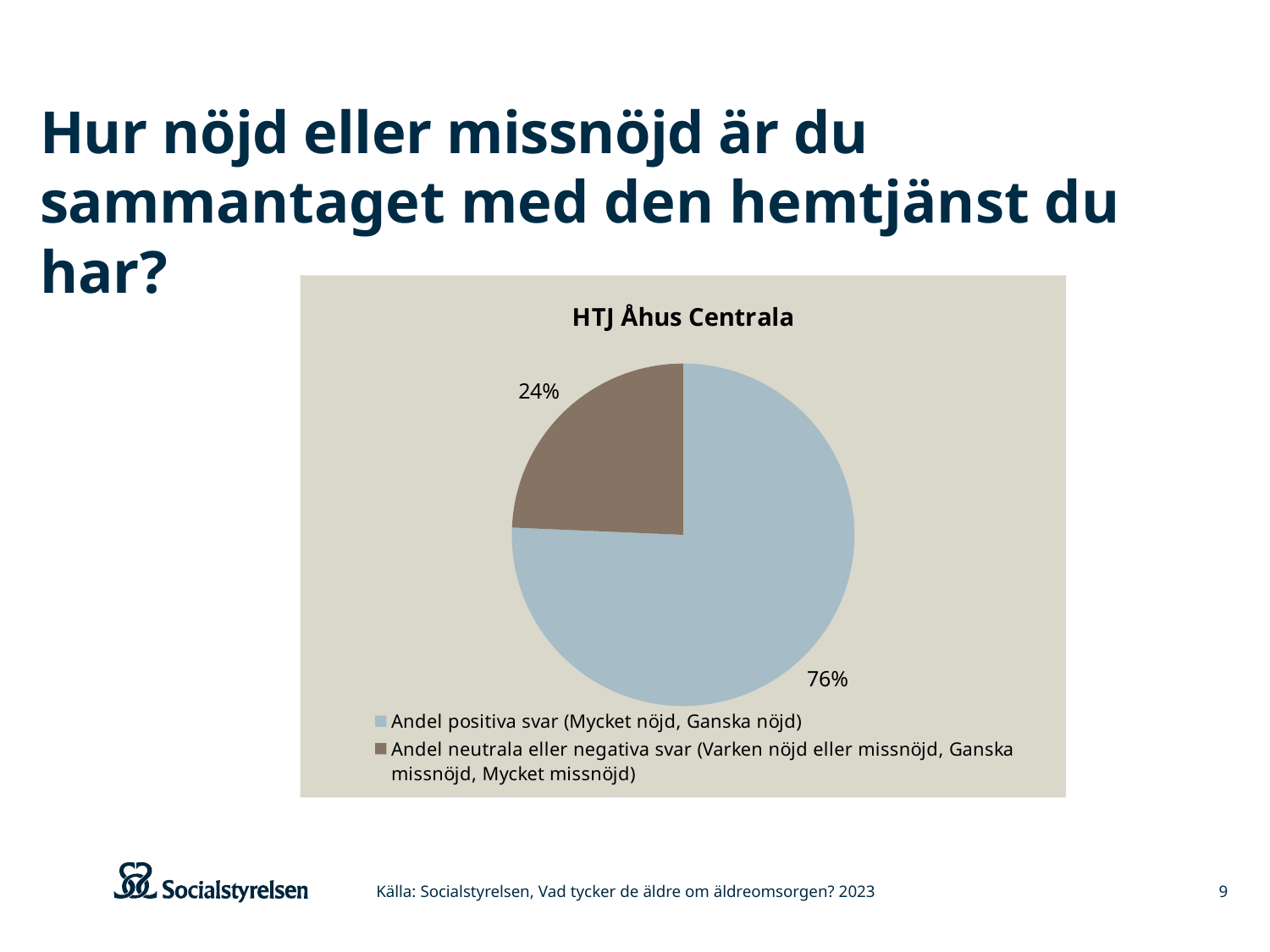
Which slice is the largest in the pie chart? Andel positiva svar (Mycket nöjd, Ganska nöjd) How many slices does the pie chart have? 2 What is the difference in percentage points between the positive share and the neutral or negative share? 52 percentage points Is the share of positive answers greater or less than 50%? greater What share of the pie is 'Andel neutrala eller negativa svar (Varken nöjd eller missnöjd, Ganska missnöjd, Mycket missnöjd)'? 24% What is the title of the chart? HTJ Åhus Centrala How many entries does the legend list? 2 What kind of chart is shown on the slide? Pie chart Which is larger: the share of positive answers or the share of neutral or negative answers? Andel positiva svar (Mycket nöjd, Ganska nöjd) What share of the pie is 'Andel positiva svar (Mycket nöjd, Ganska nöjd)'? 76% Which colour represents 'Andel positiva svar (Mycket nöjd, Ganska nöjd)' in the pie chart? Light blue Which slice is the smallest in the pie chart? Andel neutrala eller negativa svar (Varken nöjd eller missnöjd, Ganska missnöjd, Mycket missnöjd)